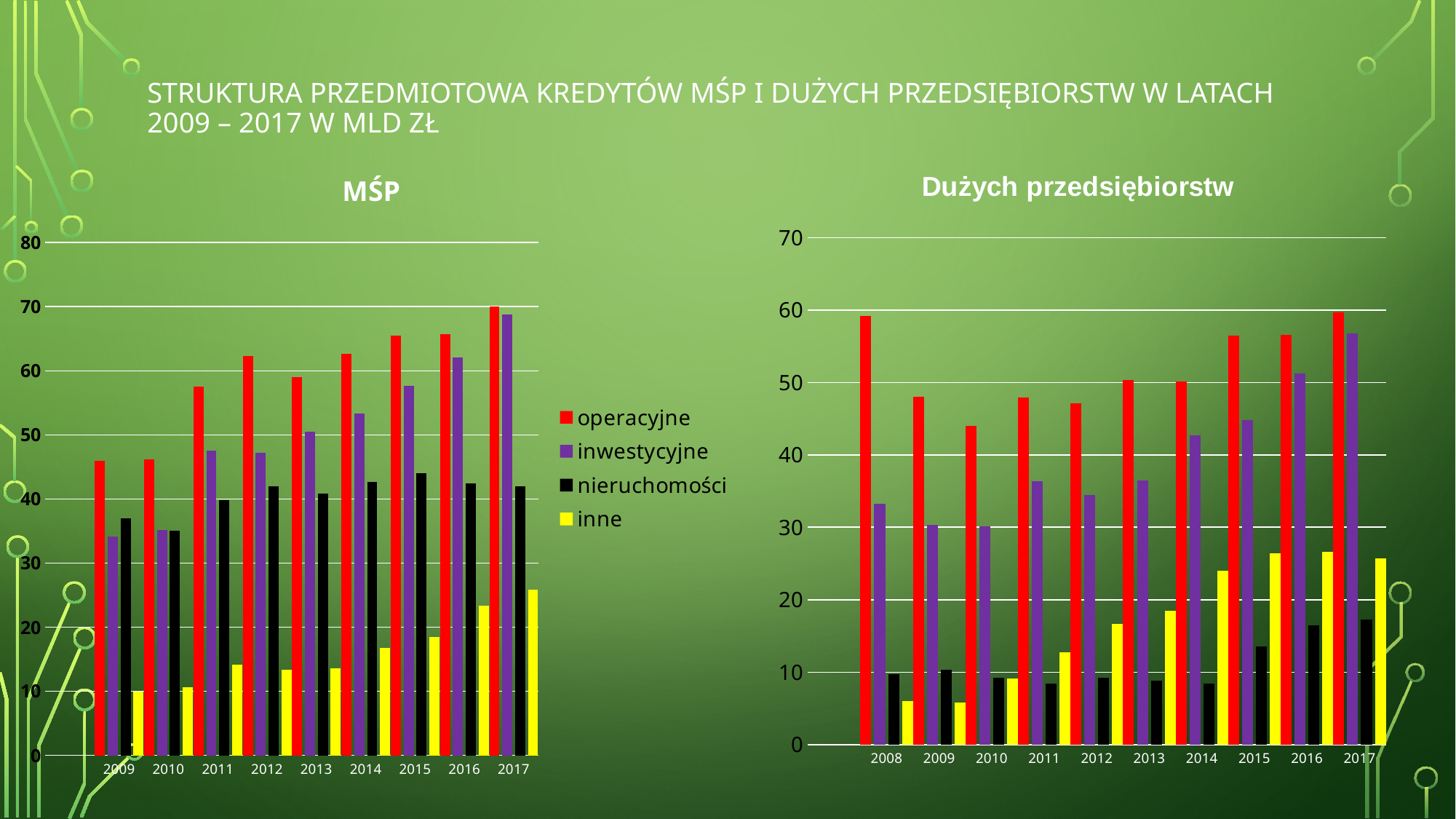
In the MŚP chart, is the inwestycyjne value for 2009 greater or less than 40? less How many years are shown on the x axis of the MŚP chart? 9 How many years are shown on the x axis of the Dużych przedsiębiorstw chart? 10 In the Dużych przedsiębiorstw chart, which year has the highest inwestycyjne value? 2017 In the Dużych przedsiębiorstw chart, do the inne values generally rise or fall from 2008 to 2017? rise What kind of chart is the MŚP chart on the left? bar chart In the Dużych przedsiębiorstw chart, is the nieruchomości value for 2015 greater or less than 20? less In the Dużych przedsiębiorstw chart, is the operacyjne value for 2008 greater or less than 50? greater How many series does the legend list? 4 In the MŚP chart, which year has the highest operacyjne value? 2017 In the Dużych przedsiębiorstw chart, which is larger in 2017: inwestycyjne or nieruchomości? inwestycyjne